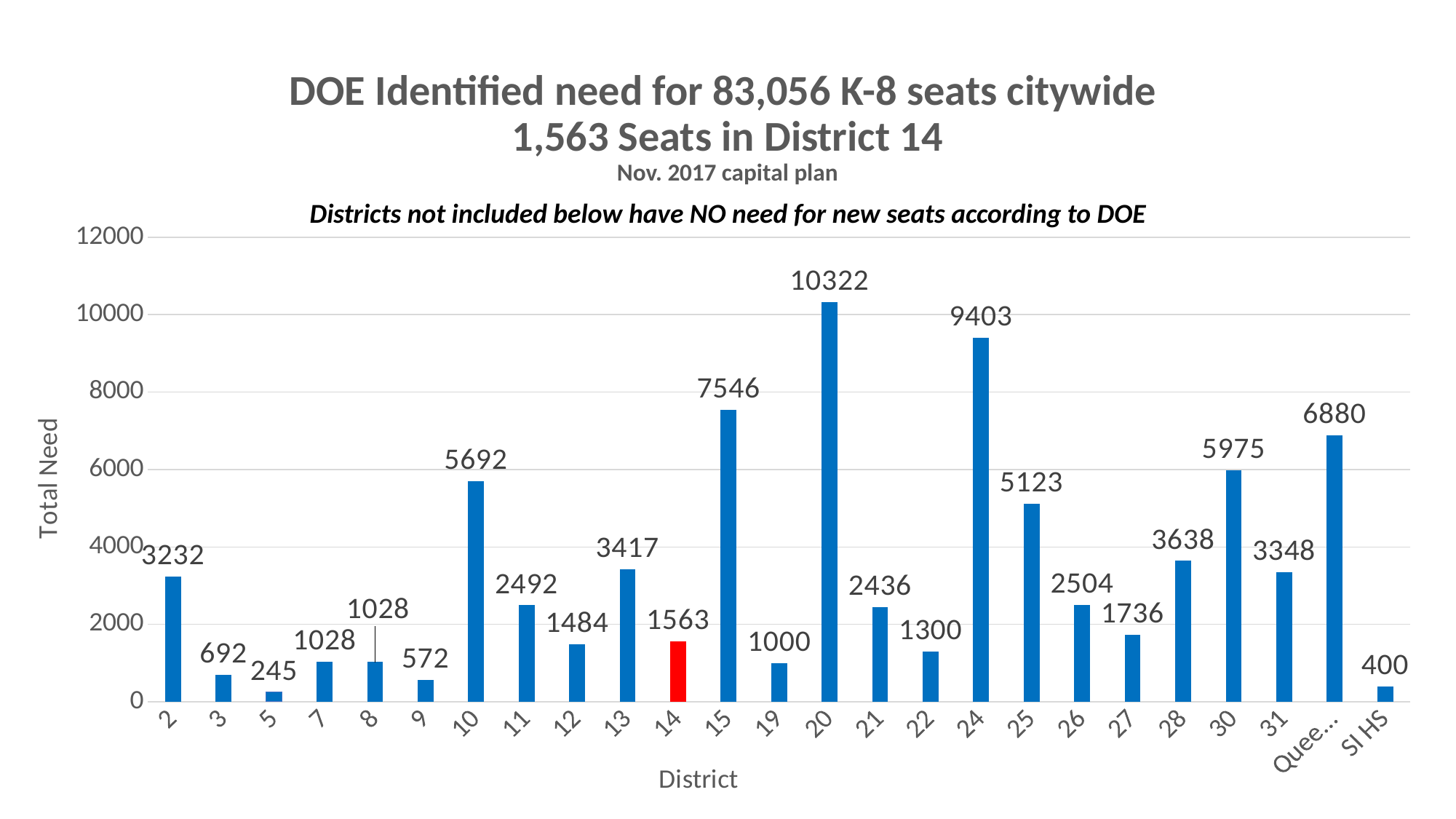
Which has a larger total need, District 10 or District 25? District 10 What is the total need for District 14? 1563 How many districts/categories are shown on the x axis? 25 Which district has the lowest total need? 5 Is the value for District 28 greater or less than 4000? less Which district's bar is coloured red instead of blue? 14 What type of chart is shown on the slide? bar chart What is the total need for District 20? 10322 What is the difference in total need between District 20 and District 24? 919 What is the difference in total need between District 15 and District 14? 5983 What is the total need for District 30? 5975 Which district has the highest total need? 20